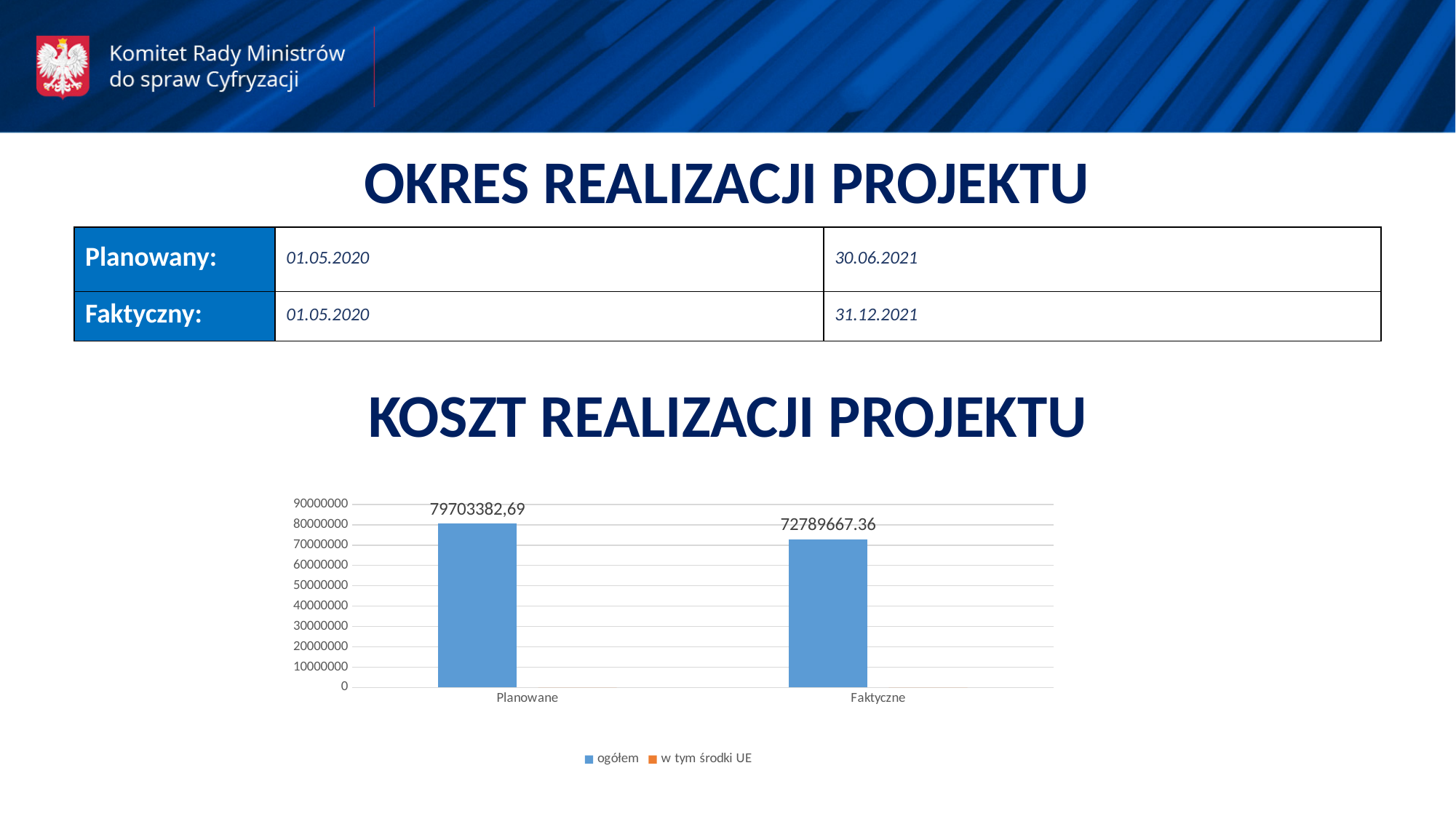
What is the value of the 'ogółem' bar for Planowane in the KOSZT REALIZACJI PROJEKTU chart? 79703382,69 What is the value of the 'ogółem' bar for Faktyczne in the KOSZT REALIZACJI PROJEKTU chart? 72789667.36 Which category has the highest 'ogółem' value in the chart? Planowane How many series does the chart legend list? 2 Do the 'ogółem' values rise or fall from Planowane to Faktyczne? Fall What are the two series names listed in the chart legend? ogółem; w tym środki UE Is the 'ogółem' value for Planowane greater or less than 70000000? greater Which category has the higher 'ogółem' value in the chart, Planowane or Faktyczne? Planowane What type of chart is shown under KOSZT REALIZACJI PROJEKTU? Bar chart Which category has the lowest 'ogółem' value in the chart? Faktyczne Is the 'ogółem' value for Faktyczne greater or less than 80000000? less How many categories are shown on the x axis of the chart? 2